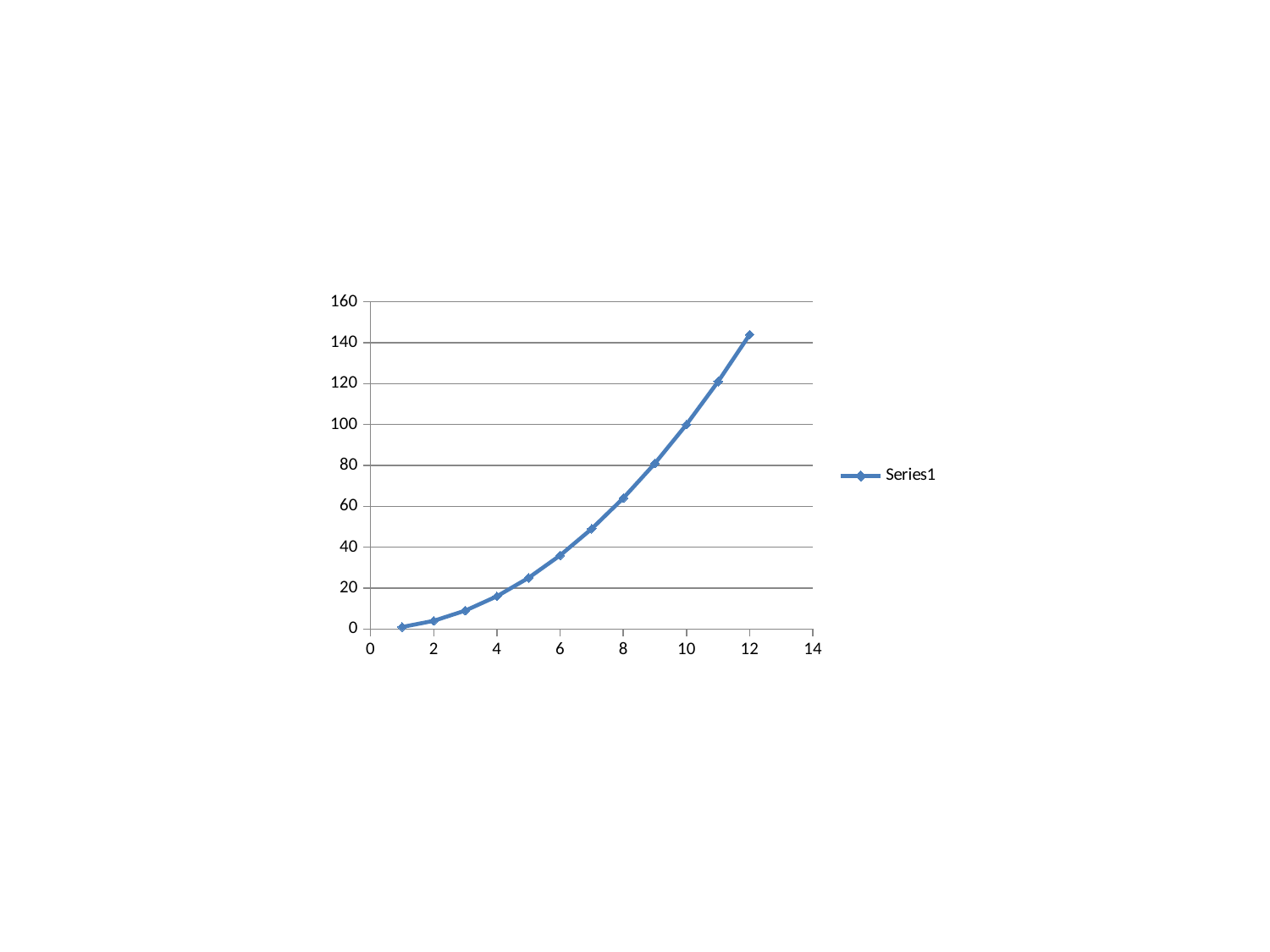
What is the name of the series shown in the legend? Series1 At which x value is the plotted value highest? 12 What kind of chart is shown on the slide? line chart Is the value at x = 7 greater or less than 60? less Which has the larger value, x = 10 or x = 6? x = 10 Is the value at x = 12 greater or less than 120? greater Is the value at x = 3 greater or less than 20? less At which x value is the plotted value lowest? 1 How many data points are plotted on the line? 12 How many series does the legend list? 1 Do the values rise or fall as x increases from 1 to 12? rise